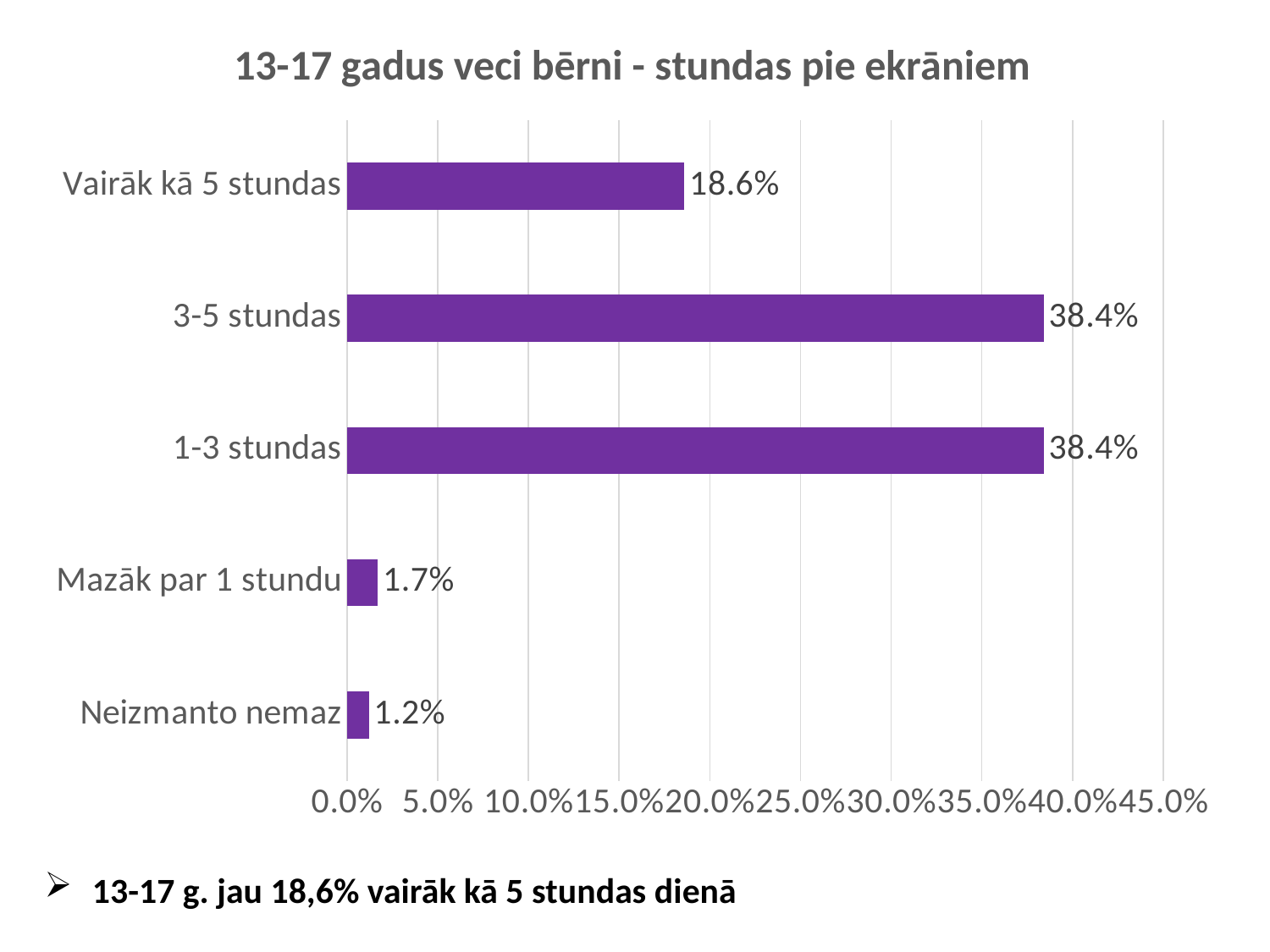
What is the value for "3-5 stundas"? 38.4% What is the value for "Neizmanto nemaz"? 1.2% Which is larger, the value for "Vairāk kā 5 stundas" or the value for "Mazāk par 1 stundu"? Vairāk kā 5 stundas What is the difference between the values for "Mazāk par 1 stundu" and "Neizmanto nemaz"? 0.5% What kind of chart is shown on the slide? bar chart Which category has the lowest value? Neizmanto nemaz What is the difference between the values for "3-5 stundas" and "Vairāk kā 5 stundas"? 19.8% What is the title of the chart? 13-17 gadus veci bērni - stundas pie ekrāniem Is the value for "1-3 stundas" greater or less than 35.0%? greater How many categories are shown in the chart? 5 What is the value for "Vairāk kā 5 stundas"? 18.6% What is the value for "Mazāk par 1 stundu"? 1.7%